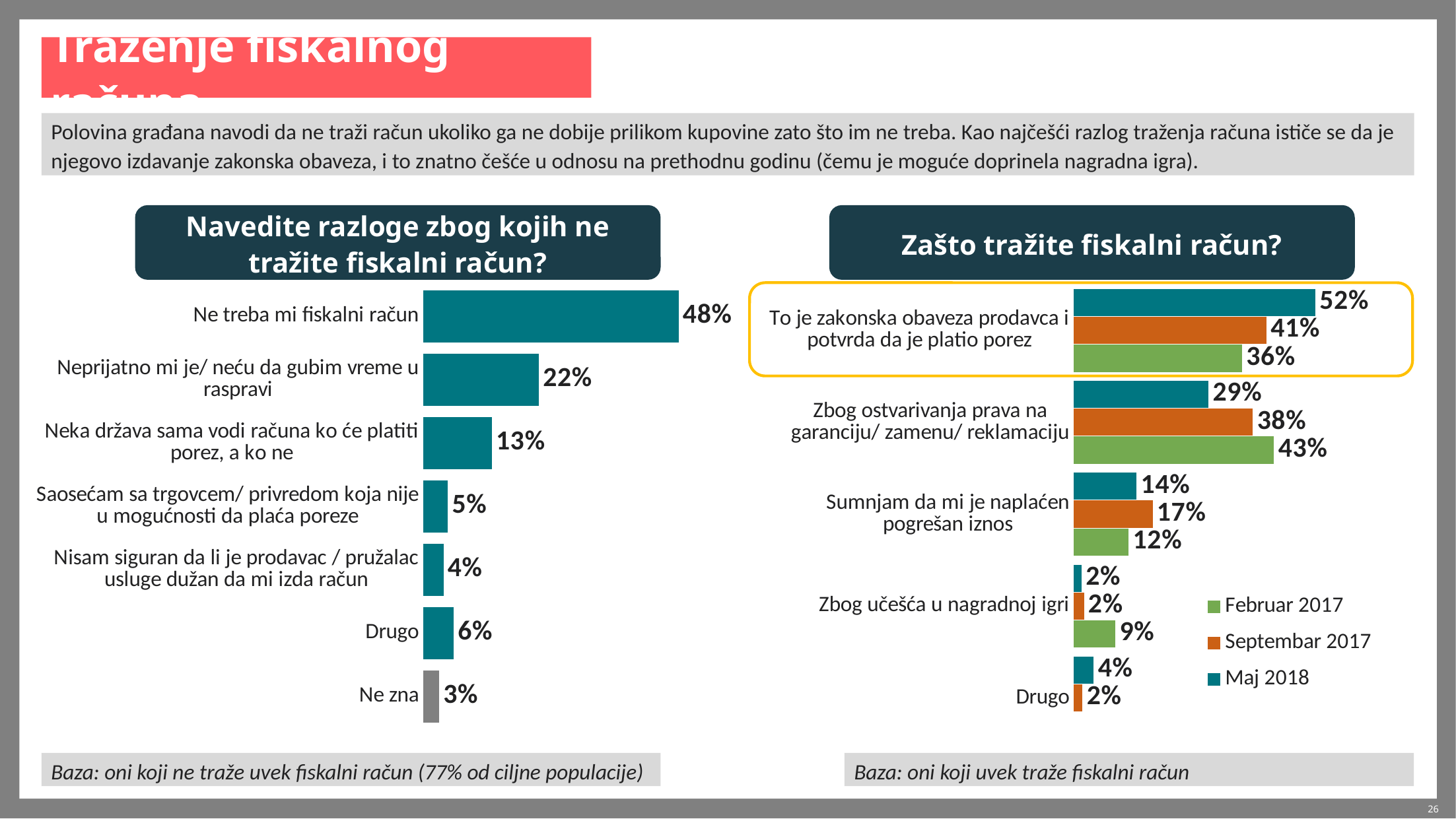
In the chart 'Zašto tražite fiskalni račun?', how many series does the legend list? 3 In the chart 'Navedite razloge zbog kojih ne tražite fiskalni račun?', which category has the lowest value? Ne zna In the chart 'Zašto tražite fiskalni račun?', what is the Maj 2018 value for 'To je zakonska obaveza prodavca i potvrda da je platio porez'? 52% In the chart 'Zašto tražite fiskalni račun?', what is the Februar 2017 value for 'Zbog ostvarivanja prava na garanciju/ zamenu/ reklamaciju'? 43% In the chart 'Navedite razloge zbog kojih ne tražite fiskalni račun?', how many categories are shown? 7 In the chart 'Navedite razloge zbog kojih ne tražite fiskalni račun?', what is the difference between 'Ne treba mi fiskalni račun' and 'Neka država sama vodi računa ko će platiti porez, a ko ne'? 35% In the chart 'Zašto tražite fiskalni račun?', which colour represents Septembar 2017 in the legend? Orange In the chart 'Zašto tražite fiskalni račun?', which is larger for 'Sumnjam da mi je naplaćen pogrešan iznos': Septembar 2017 or Februar 2017? Septembar 2017 In the chart 'Navedite razloge zbog kojih ne tražite fiskalni račun?', what is the value for 'Neprijatno mi je/ neću da gubim vreme u raspravi'? 22% What type of chart is 'Zašto tražite fiskalni račun?'? Bar chart In the chart 'Navedite razloge zbog kojih ne tražite fiskalni račun?', what is the value for 'Ne treba mi fiskalni račun'? 48% In the chart 'Zašto tražite fiskalni račun?', what is the difference between the Maj 2018 and Februar 2017 values for 'To je zakonska obaveza prodavca i potvrda da je platio porez'? 16%